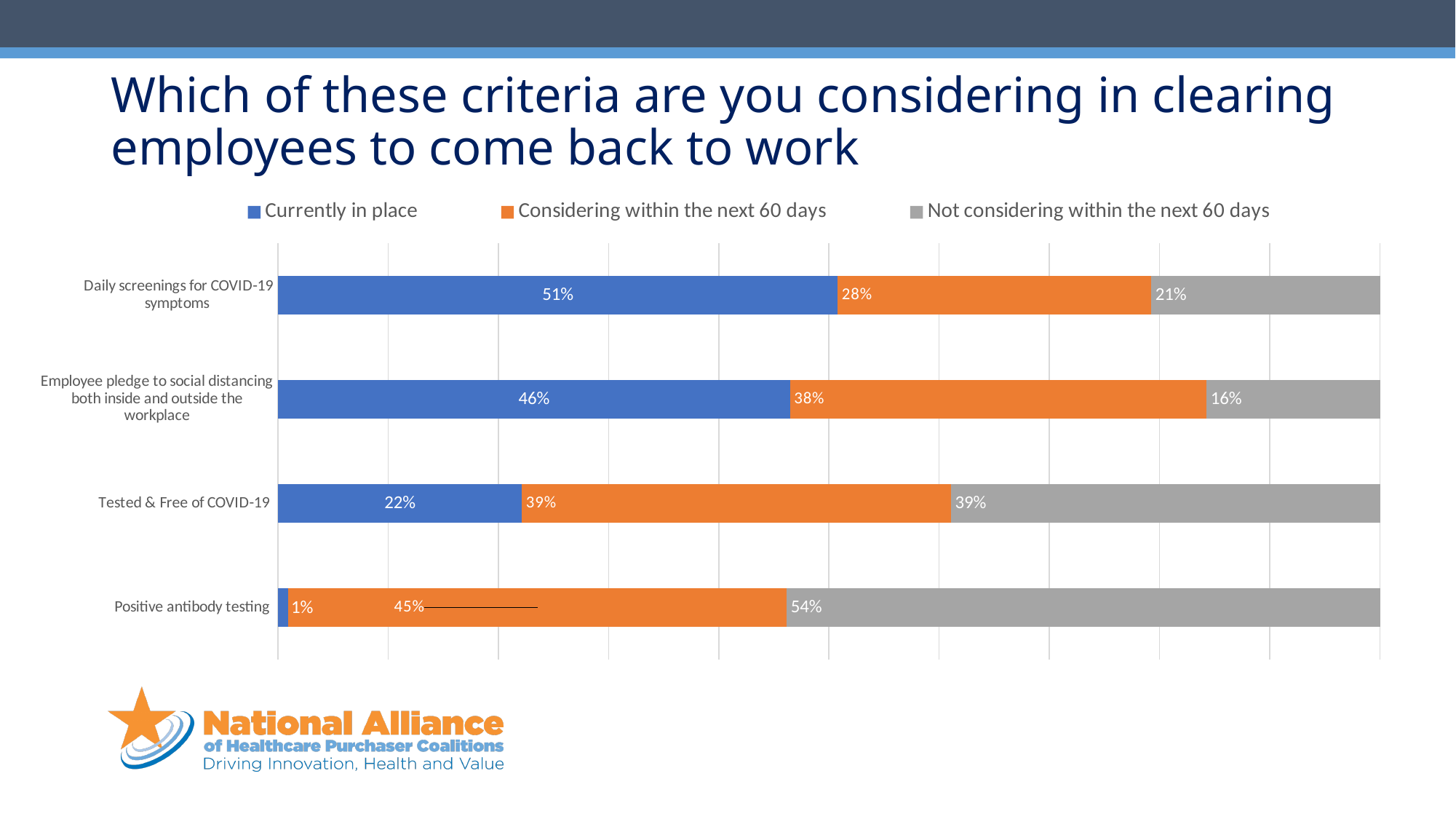
What percentage of respondents currently have daily screenings for COVID-19 symptoms in place? 51% Which is larger: the 'Not considering within the next 60 days' value for Tested & Free of COVID-19 or for Daily screenings for COVID-19 symptoms? Tested & Free of COVID-19 How many series does the legend list? 3 What is the difference between the 'Currently in place' values for Daily screenings for COVID-19 symptoms and Tested & Free of COVID-19? 29% What is the 'Currently in place' value for Tested & Free of COVID-19? 22% Which criterion has the lowest 'Currently in place' percentage? Positive antibody testing How many criteria (categories) are shown in the chart? 4 What is the 'Not considering within the next 60 days' value for Positive antibody testing? 54% What type of chart is shown on the slide? Stacked bar chart What is the 'Considering within the next 60 days' value for Employee pledge to social distancing both inside and outside the workplace? 38% Which colour represents 'Considering within the next 60 days' in the chart? Orange Which criterion has the highest 'Currently in place' percentage? Daily screenings for COVID-19 symptoms